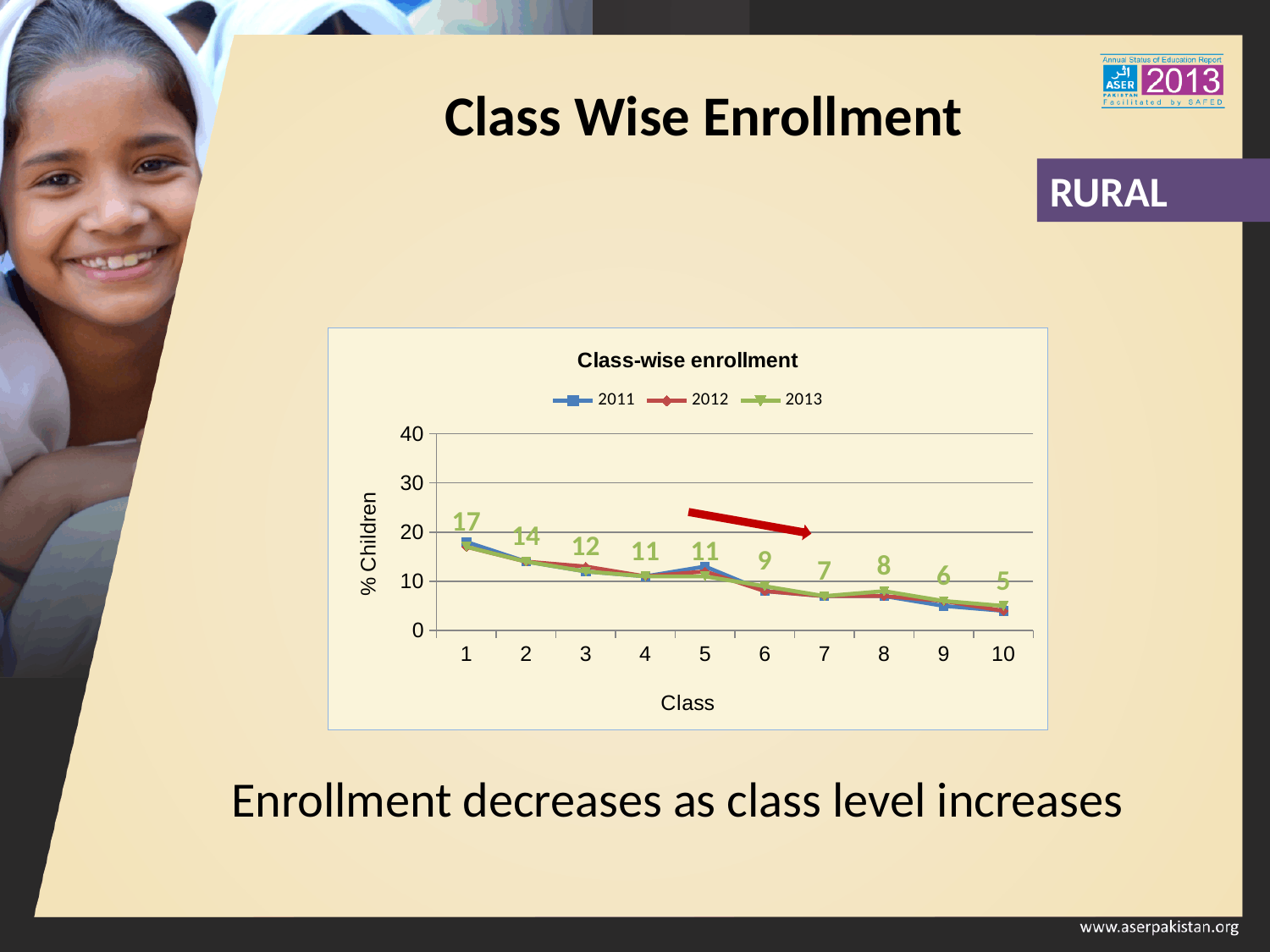
What kind of chart is shown? line chart What is the 2013 enrollment value for class 1? 17 For 2013, which is larger: the value for class 2 or the value for class 3? class 2 What is the difference between the 2013 values for class 1 and class 10? 12 What is the 2013 enrollment value for class 6? 9 Which class has the highest 2013 enrollment value? 1 What is the 2013 enrollment value for class 10? 5 How many series does the legend list? 3 Which class has the lowest 2013 enrollment value? 10 How many classes are shown on the x axis? 10 Is the 2011 value for class 1 greater or less than 10? greater Do the enrollment values rise or fall as the class level increases? fall